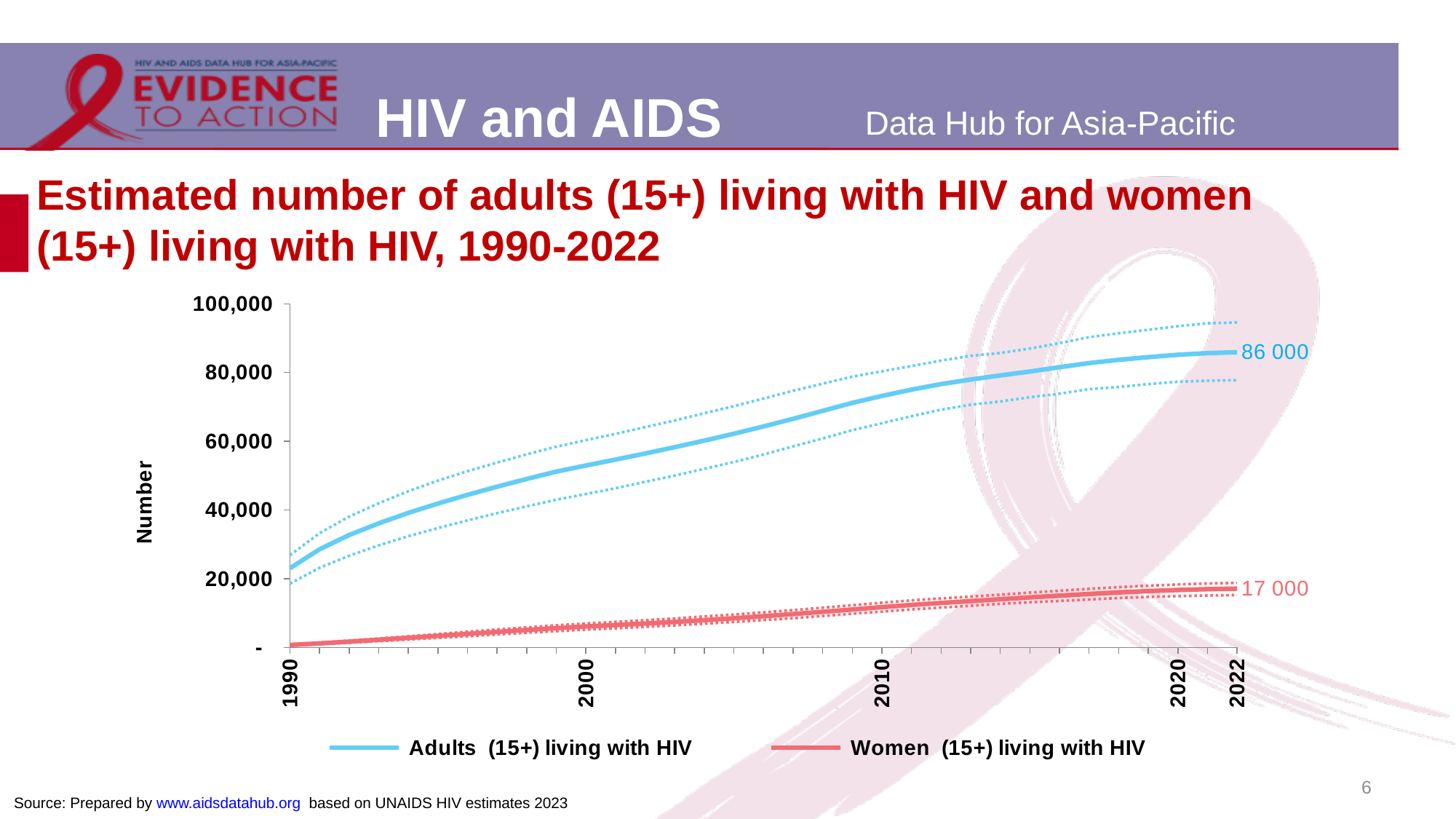
Is the value for adults (15+) living with HIV in 2010 greater or less than 60,000? greater Is the value for women (15+) living with HIV in 2000 greater or less than 20,000? less What kind of chart is shown on the slide? Line chart What colour is the line for women (15+) living with HIV? Red Does the number of adults (15+) living with HIV rise or fall from 1990 to 2022? Rise What is the estimated number of adults (15+) living with HIV in 2022? 86 000 Which series has the higher value in 2022, adults (15+) living with HIV or women (15+) living with HIV? Adults (15+) living with HIV What is the estimated number of women (15+) living with HIV in 2022? 17 000 How many series does the legend list? 2 Is the value for adults (15+) living with HIV in 1990 greater or less than 40,000? less What is the difference between the 2022 values for adults (15+) living with HIV and women (15+) living with HIV? 69 000 What is the label of the y axis? Number